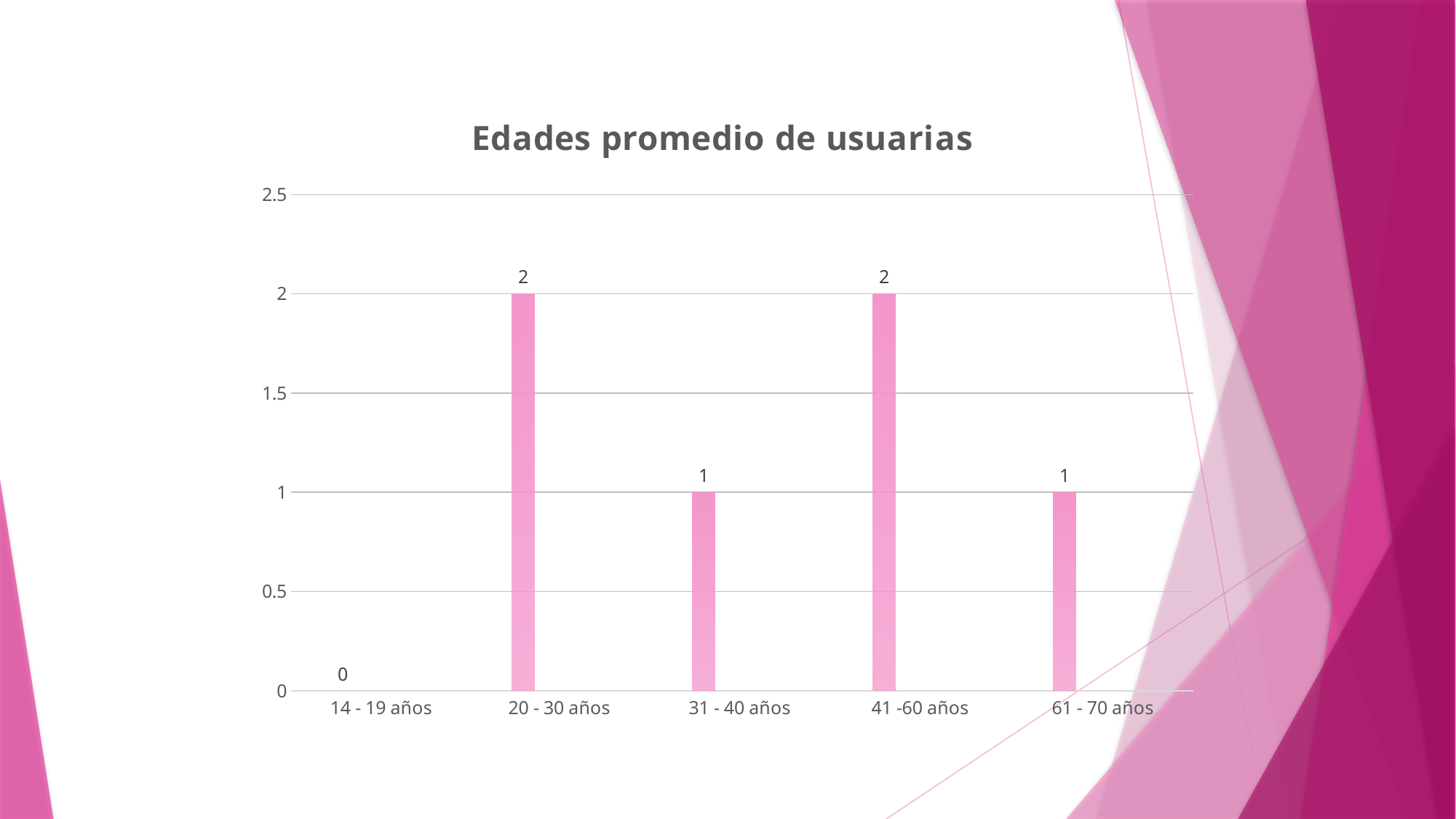
What is the value for 61 - 70 años? 1 What is the value for 20 - 30 años? 2 Which category has the lowest value? 14 - 19 años What is the value for 14 - 19 años? 0 What kind of chart is this? bar chart What is the value for 31 - 40 años? 1 Which is larger, the value for 41 -60 años or the value for 61 - 70 años? 41 -60 años What is the total of the values for 20 - 30 años and 41 -60 años? 4 What is the title of the chart? Edades promedio de usuarias How many categories are shown on the x axis? 5 What is the difference between the values for 20 - 30 años and 31 - 40 años? 1 What is the highest value shown on the y axis? 2.5